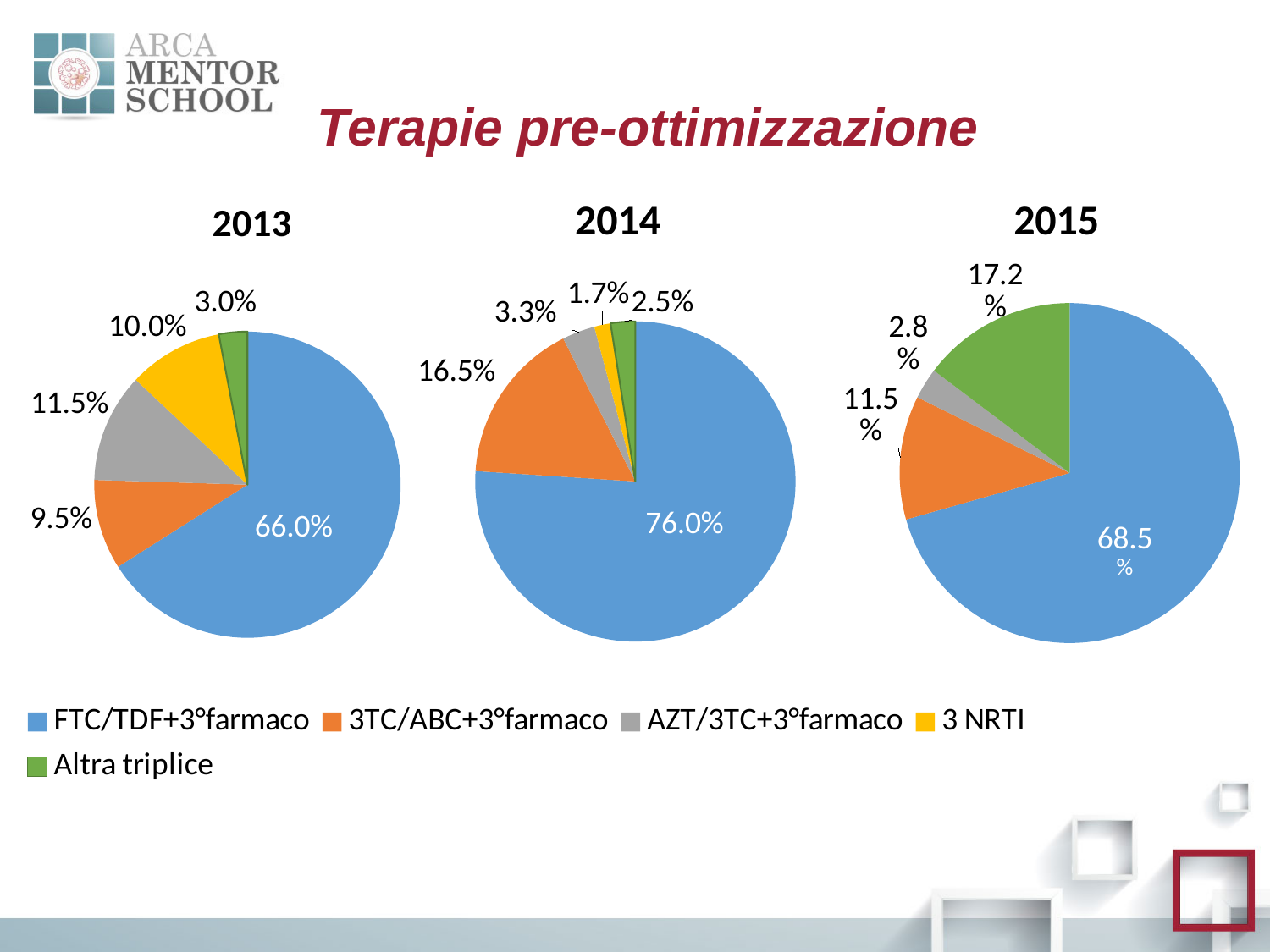
What kind of chart is used for 2014? Pie chart In the 2015 pie chart, what share is Altra triplice? 17.2% Which legend entry is shown in green? Altra triplice In the 2013 pie chart, what share is 3 NRTI? 10.0% How many entries does the legend list? 5 In the 2014 pie chart, which category has the smallest share? 3 NRTI How many slices does the 2015 pie chart have? 4 In the 2014 pie chart, what share is 3TC/ABC+3°farmaco? 16.5% In the 2013 pie chart, what share is FTC/TDF+3°farmaco? 66.0% In the 2015 pie chart, which category has the largest share? FTC/TDF+3°farmaco What is the difference between the FTC/TDF+3°farmaco share in the 2014 pie chart and in the 2013 pie chart? 10.0% In the 2013 pie chart, which is larger: AZT/3TC+3°farmaco or 3TC/ABC+3°farmaco? AZT/3TC+3°farmaco